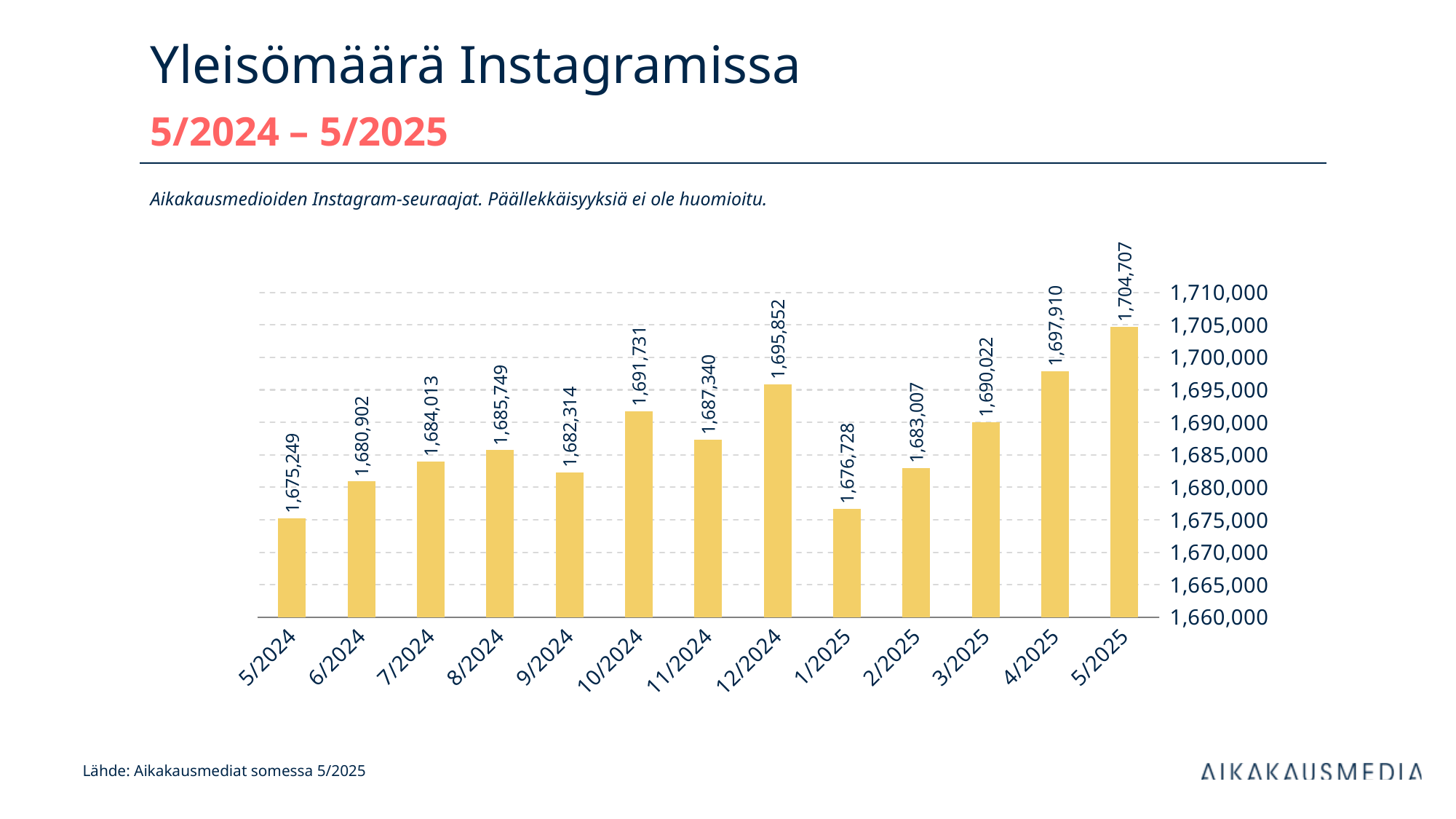
What kind of chart is shown on the slide? bar chart What is the value for 1/2025? 1,676,728 How many months are shown on the x axis? 13 What is the difference between the values for 12/2024 and 1/2025? 19,124 Is the value for 4/2025 greater or less than 1,695,000? greater What is the value for 12/2024? 1,695,852 What is the title of the chart on the slide? Yleisömäärä Instagramissa Which month has the highest value? 5/2025 Which month has the lowest value? 5/2024 What is the value for 5/2024? 1,675,249 What is the difference between the values for 5/2025 and 5/2024? 29,458 Which is larger, the value for 10/2024 or the value for 11/2024? 10/2024